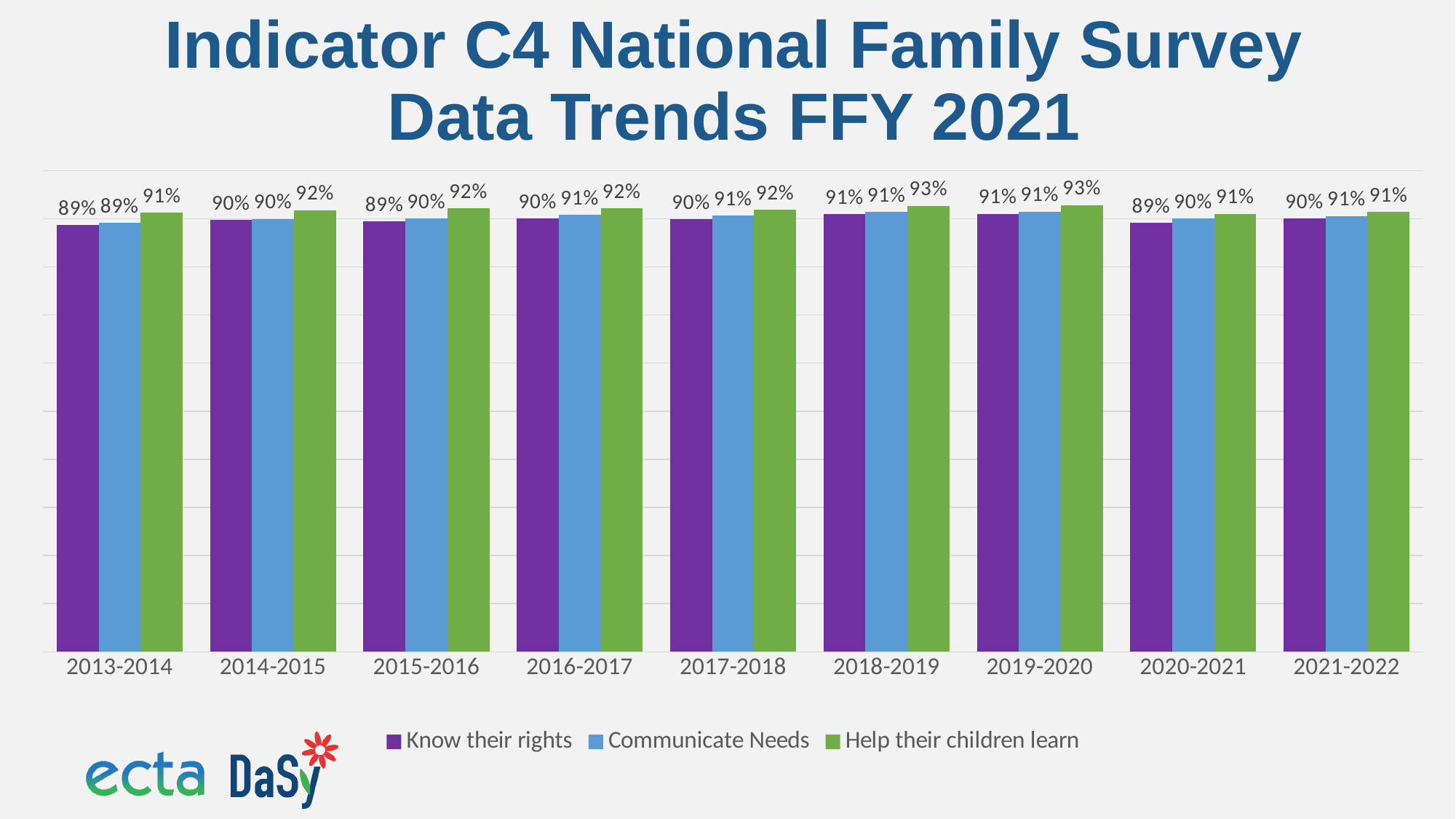
What is the difference between Help their children learn and Know their rights in 2014-2015? 2% What is the title of the chart? Indicator C4 National Family Survey Data Trends FFY 2021 What type of chart is shown on the slide? Bar chart How many year categories are shown on the x axis? 9 What is the difference between Help their children learn in 2019-2020 and in 2020-2021? 2% What is the value for Know their rights in 2020-2021? 89% What is the value for Communicate Needs in 2021-2022? 91% How many series does the legend list? 3 What is the value for Know their rights in 2013-2014? 89% Which series is shown in green in the legend? Help their children learn In 2013-2014, which is larger: Help their children learn or Know their rights? Help their children learn What is the value for Help their children learn in 2018-2019? 93%